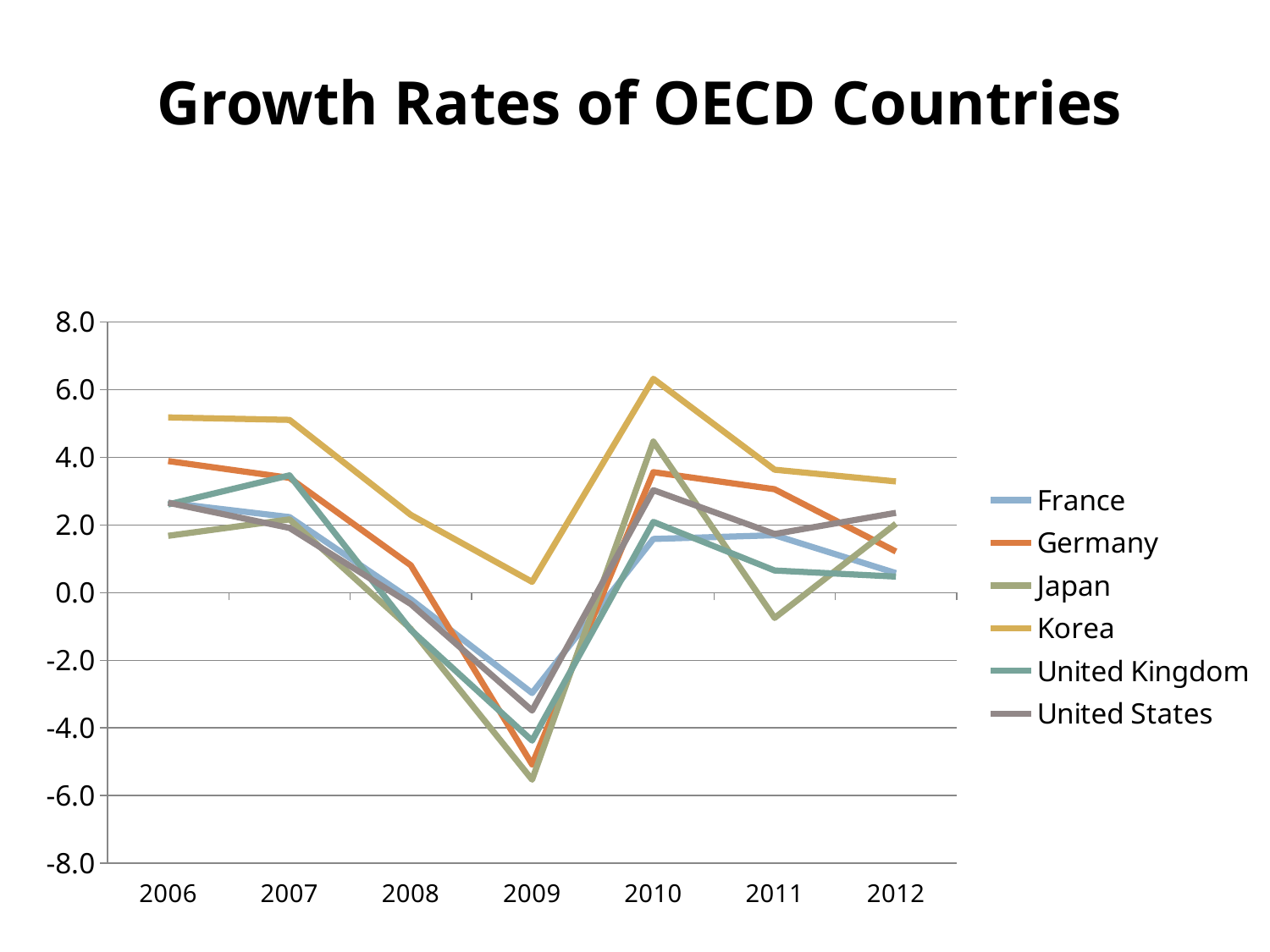
What kind of chart is shown on the slide? Line chart Is the growth rate for Japan in 2009 greater or less than -4.0? less Does the growth rate for Korea rise or fall from 2010 to 2012? Fall How many years are shown along the x axis? 7 What is the title of the chart? Growth Rates of OECD Countries Which country has the highest growth rate in 2010? Korea Which is larger in 2011, the growth rate of Germany or of Japan? Germany Is the growth rate for Korea in 2006 greater or less than 4.0? greater Which country has the highest growth rate in 2009? Korea Which country has the lowest growth rate in 2011? Japan How many countries does the legend list? 6 Which country is plotted with the yellow line? Korea